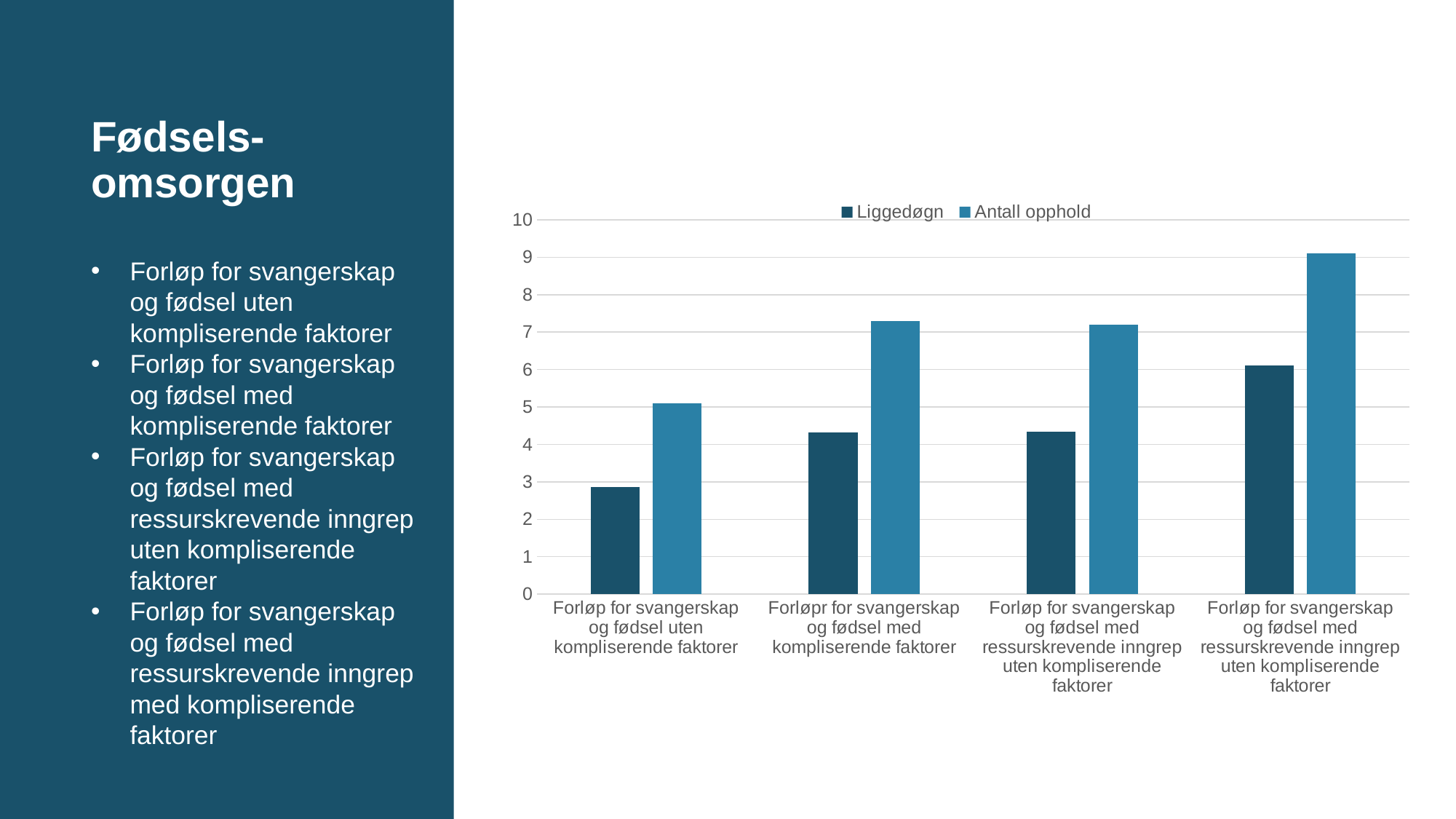
Is the Antall opphold value for the rightmost category greater or less than 8? greater Is the Liggedøgn value for Forløp for svangerskap og fødsel uten kompliserende faktorer greater or less than 4? less Which category has the lowest Antall opphold value? Forløp for svangerskap og fødsel uten kompliserende faktorer Which is larger: the Liggedøgn value for the rightmost category or the Liggedøgn value for the leftmost category? The rightmost category Which category has the highest Antall opphold value? The fourth category from the left (Forløp for svangerskap og fødsel med ressurskrevende inngrep uten kompliserende faktorer, rightmost) What kind of chart is shown on the slide? Bar chart Which category has the lowest Liggedøgn value? Forløp for svangerskap og fødsel uten kompliserende faktorer How many categories are shown along the x axis of the chart? 4 How many series does the chart legend list? 2 What are the two series named in the chart legend? Liggedøgn and Antall opphold Is the Antall opphold value for Forløpr for svangerskap og fødsel med kompliserende faktorer greater or less than 6? greater For Forløp for svangerskap og fødsel uten kompliserende faktorer, which is larger: Liggedøgn or Antall opphold? Antall opphold